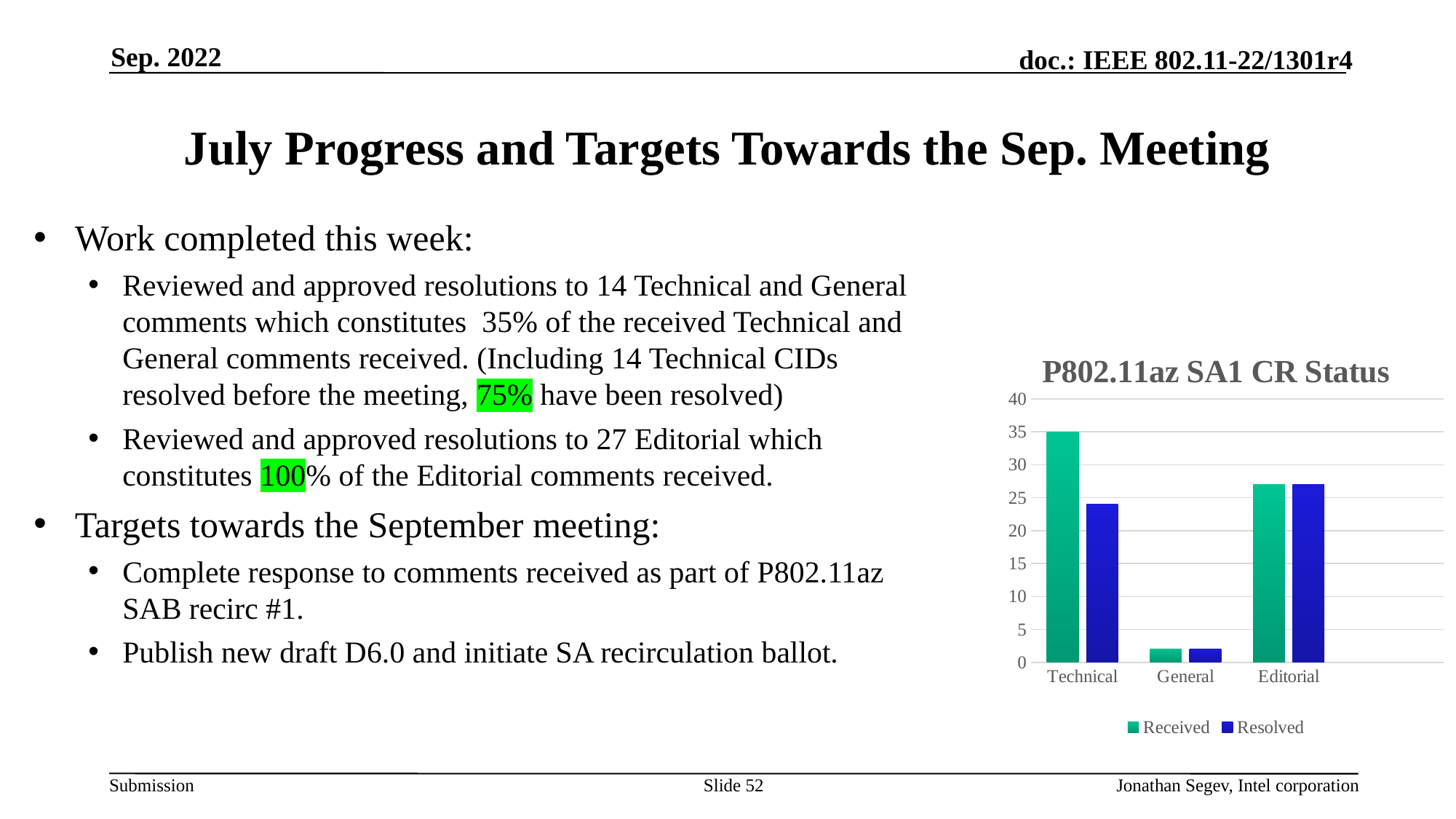
For Technical, which is larger: Received or Resolved? Received What is the title of the chart? P802.11az SA1 CR Status Which category has the highest Received value? Technical Which series is shown in dark blue in the chart legend? Resolved Is the Received value for General greater or less than 5? less How many categories are shown on the x axis of the chart? 3 Is the Resolved value for Technical greater or less than 20? greater How many series does the chart legend list? 2 What kind of chart is shown on the slide? bar chart Which category has the lowest Received value? General Is the Received value for Editorial greater or less than 25? greater Which category has the lowest Resolved value? General